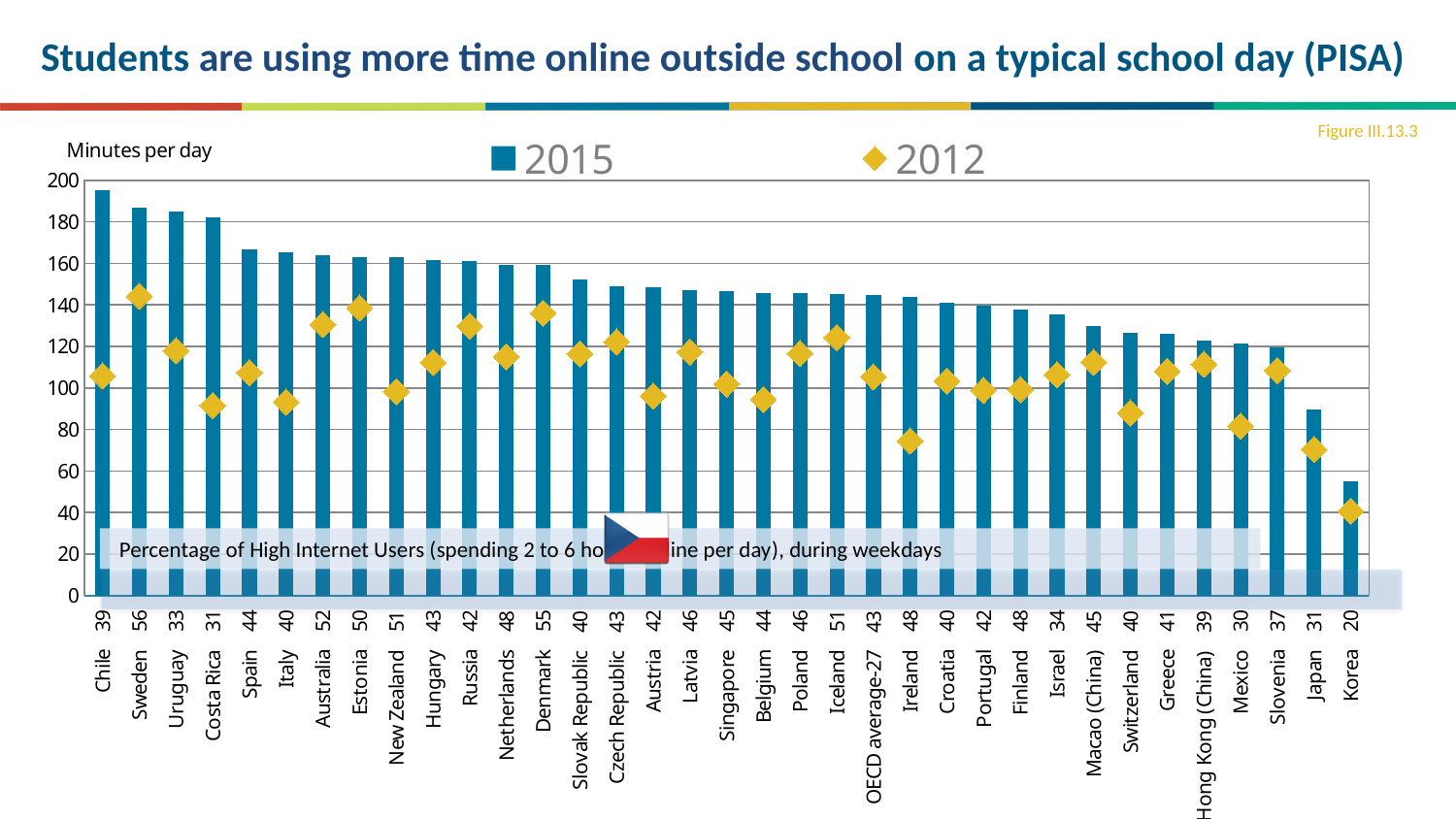
Which country has the highest 2015 value? Chile Is the 2015 value for Japan greater or less than 100? less How many series does the legend list? 2 Which is larger, the 2012 value for Sweden or the 2012 value for Costa Rica? Sweden Which is larger, the 2015 value for Japan or the 2015 value for Korea? Japan What is the label on the vertical axis? Minutes per day Is the 2015 value for Chile greater or less than 180? greater What kind of chart is shown on the slide? bar chart Which country has the lowest 2015 value? Korea Do the 2015 values rise or fall from left to right along the x axis? fall Is the 2012 value for Ireland greater or less than 80? less Which country has the lowest 2012 value? Korea